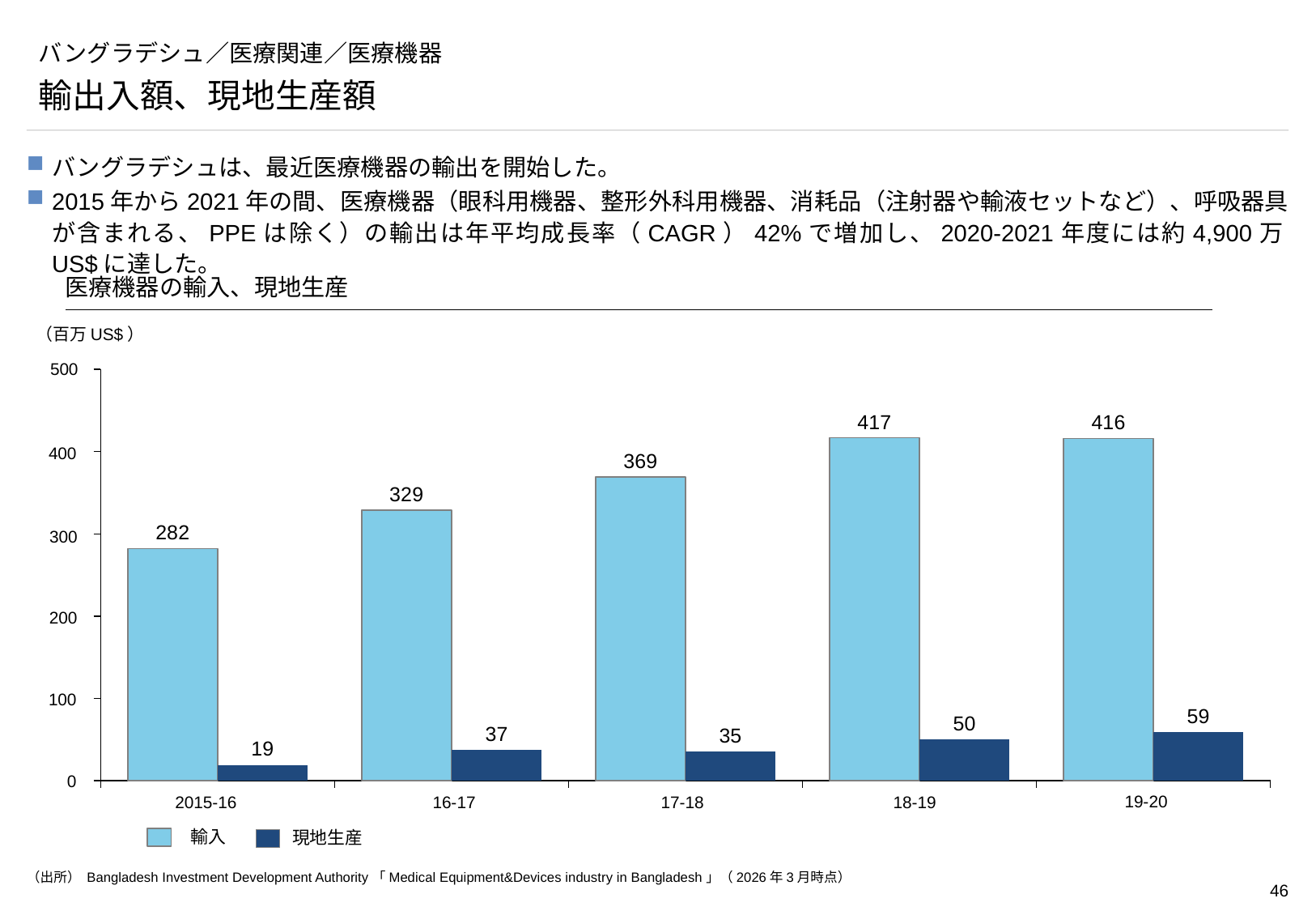
Is the 輸入 value for 17-18 greater or less than 400? less What kind of chart is shown on the slide? bar chart Which year has the highest 輸入 value? 18-19 What is the value of 輸入 (imports) for 2015-16? 282 How many series does the legend list? 2 What unit is shown for the y axis? 百万 US$ Which year has the lowest 現地生産 value? 2015-16 How many year categories are shown on the x axis? 5 Which is larger, the 現地生産 value for 16-17 or for 17-18? 16-17 What is the difference between the 輸入 values for 16-17 and 2015-16? 47 What is the value of 現地生産 (local production) for 19-20? 59 What is the value of 輸入 for 17-18? 369